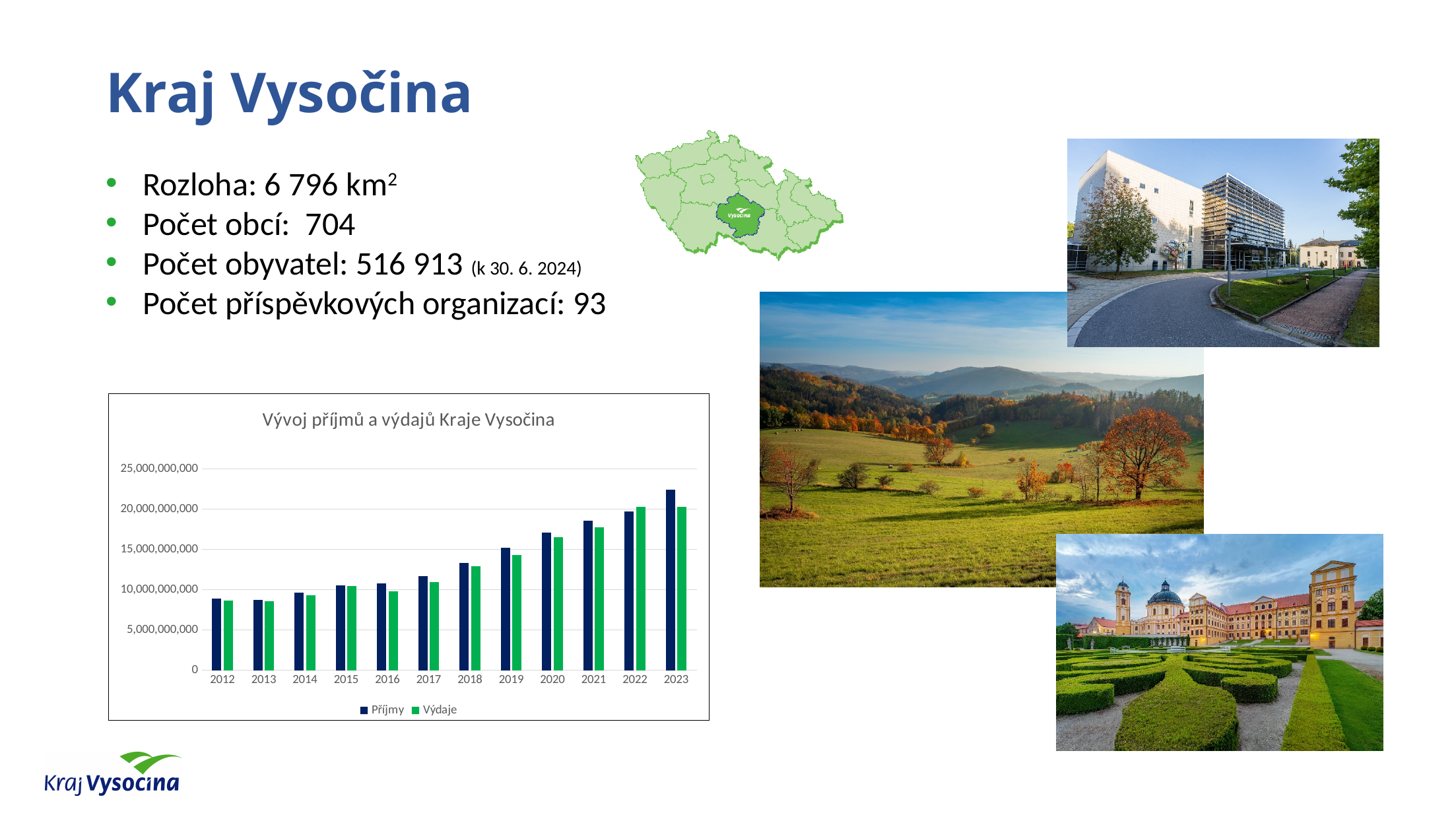
Is the Příjmy value for 2021 greater or less than 15,000,000,000? greater In which year is the Příjmy value highest? 2023 What is the title of the chart on the slide? Vývoj příjmů a výdajů Kraje Vysočina Is the Výdaje value for 2012 greater or less than 10,000,000,000? less What kind of chart is shown on the slide? bar chart Is the Příjmy value for 2023 greater or less than 20,000,000,000? greater Which series are listed in the chart's legend? Příjmy, Výdaje Do the Příjmy values generally rise or fall from 2012 to 2023? rise How many series does the chart's legend list? 2 How many years are shown on the x axis of the chart? 12 In 2023, which is larger, Příjmy or Výdaje? Příjmy